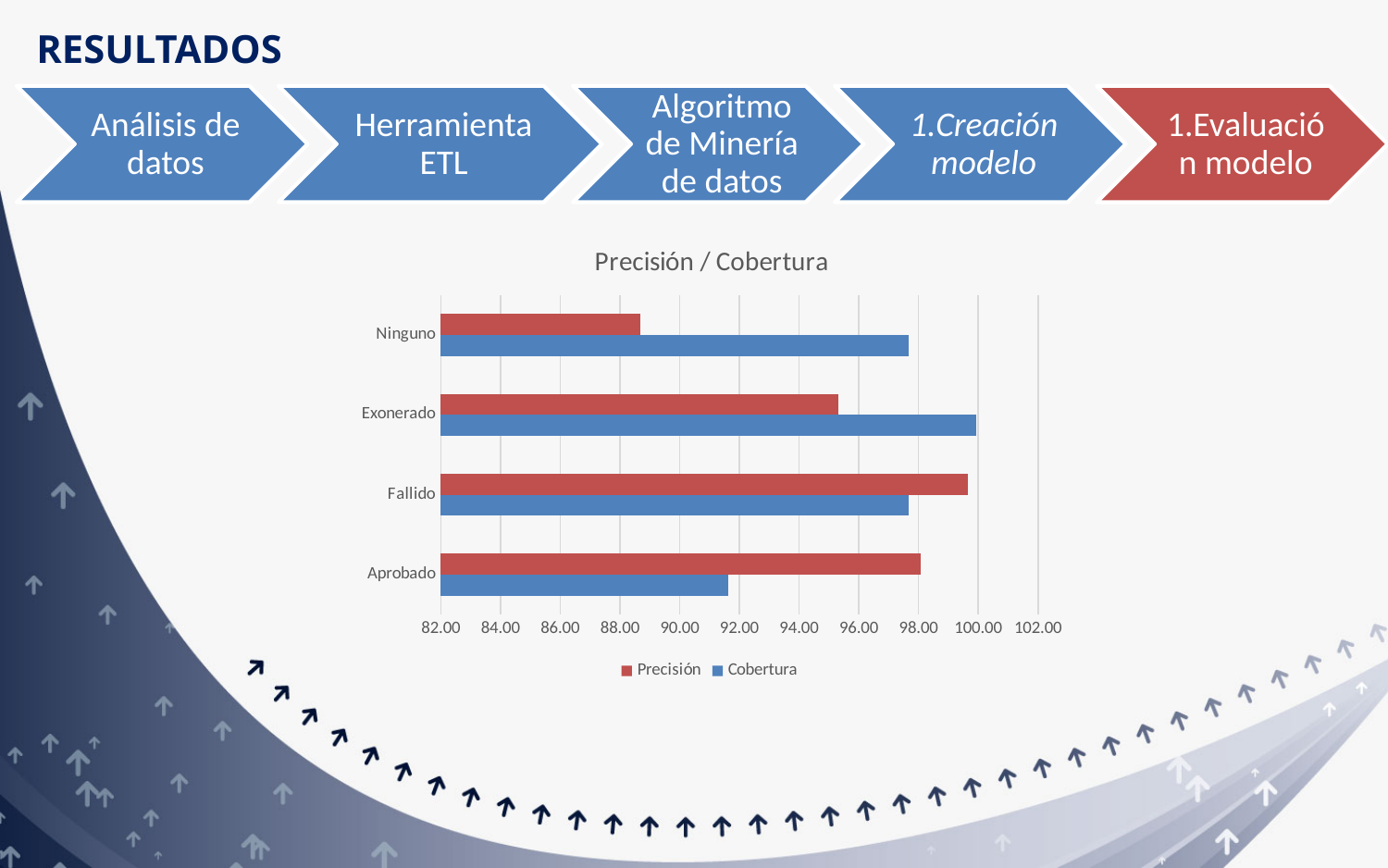
For Aprobado, which is larger: Precisión or Cobertura? Precisión Is the Cobertura value for Aprobado greater or less than 92.00? less How many categories are shown on the chart? 4 Which series is shown in red? Precisión Is the Precisión value for Ninguno greater or less than 90.00? less Is the Precisión value for Fallido greater or less than 98.00? greater Which category has the lowest Precisión value? Ninguno What is the title of the chart? Precisión / Cobertura How many series does the legend list? 2 What kind of chart is shown on the slide? bar chart Which category has the highest Cobertura value? Exonerado